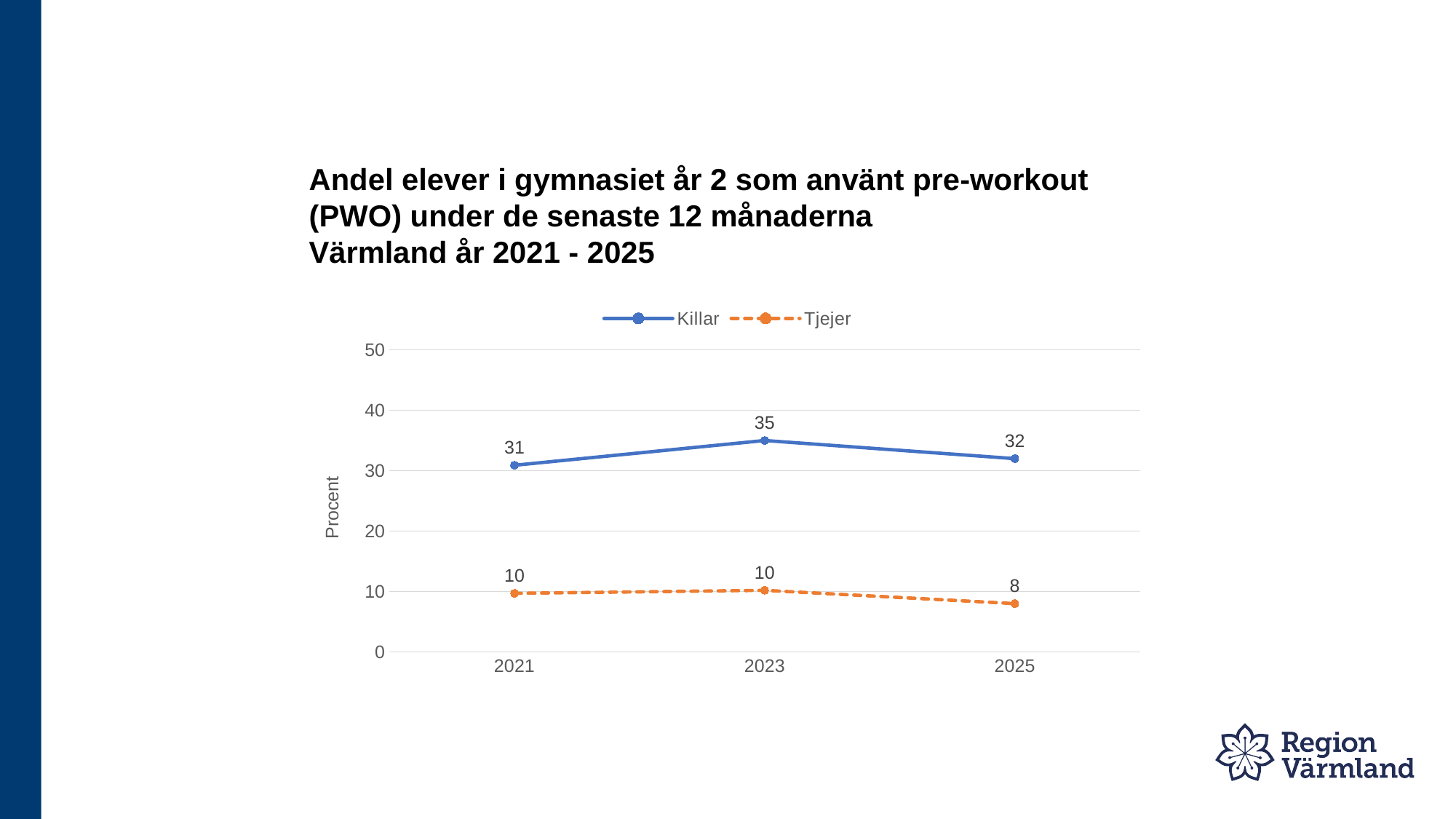
What is the value for Killar in 2021? 31 What is the value for Killar in 2023? 35 Which series has the larger value in 2021, Killar or Tjejer? Killar What is the value for Tjejer in 2025? 8 What is the difference between the Killar values in 2023 and 2021? 4 How many series does the legend list? 2 What kind of chart is shown on the slide? Line chart How many years are shown on the x axis? 3 What is the difference between the Killar and Tjejer values in 2025? 24 What is the label of the y axis? Procent In which year is the value for Killar highest? 2023 In which year is the value for Tjejer lowest? 2025